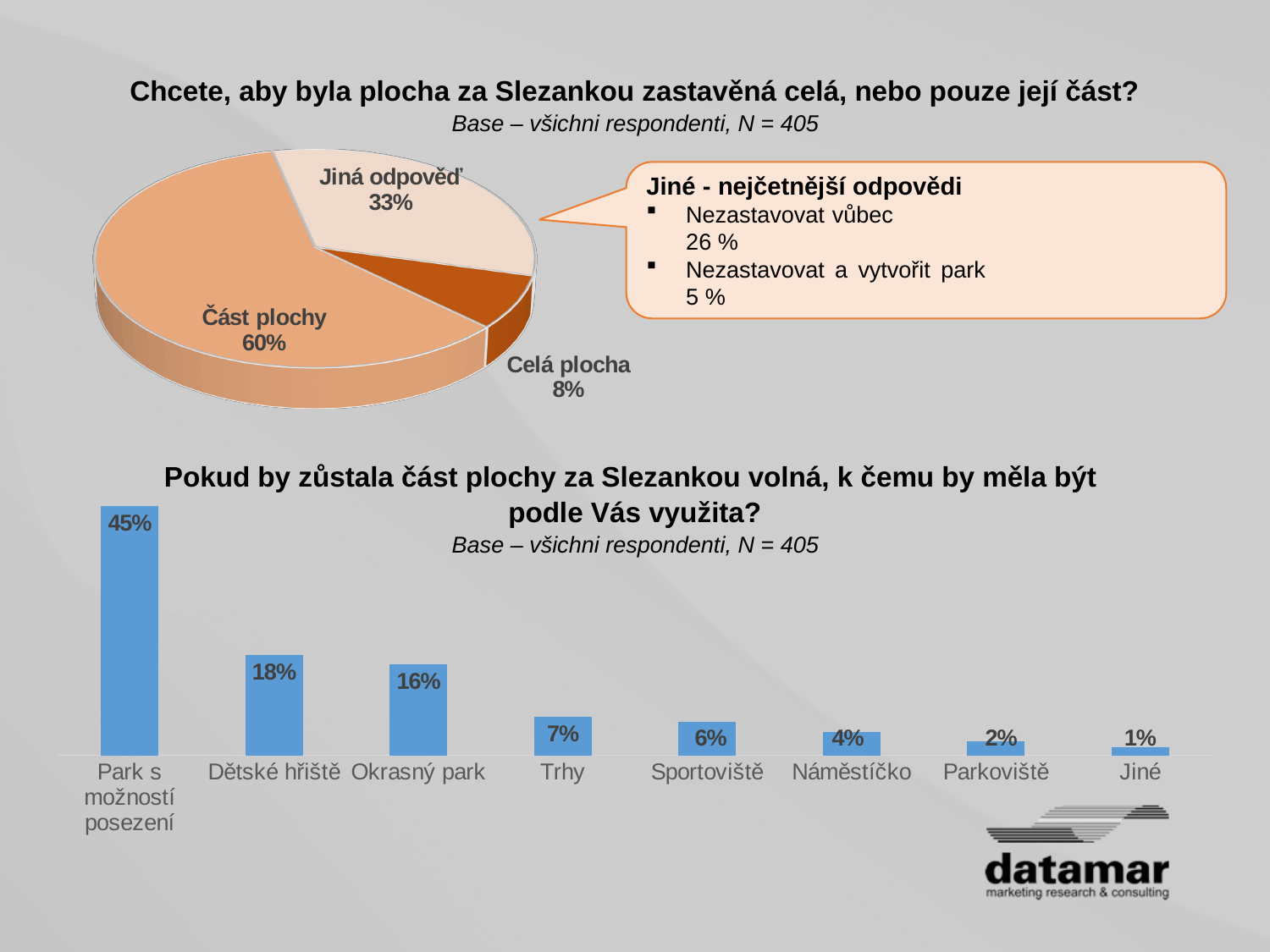
In the pie chart at the top of the slide, what share of respondents chose "Celá plocha"? 8% In the pie chart at the top of the slide, what share of respondents chose "Část plochy"? 60% In the pie chart at the top of the slide, which category has the largest slice? Část plochy In the bar chart at the bottom of the slide, what is the difference between "Park s možností posezení" and "Okrasný park"? 29 percentage points In the bar chart at the bottom of the slide, which category has the lowest value? Jiné In the bar chart at the bottom of the slide, which category has the highest value? Park s možností posezení In the pie chart at the top of the slide, what is the difference in percentage points between "Část plochy" and "Jiná odpověď"? 27 percentage points In the bar chart at the bottom of the slide, what is the value for "Dětské hřiště"? 18% In the bar chart at the bottom of the slide, how many categories are shown? 8 In the pie chart at the top of the slide, how many slices are there? 3 In the pie chart at the top of the slide, which category has the smallest slice? Celá plocha In the bar chart at the bottom of the slide, what is the value for "Sportoviště"? 6%